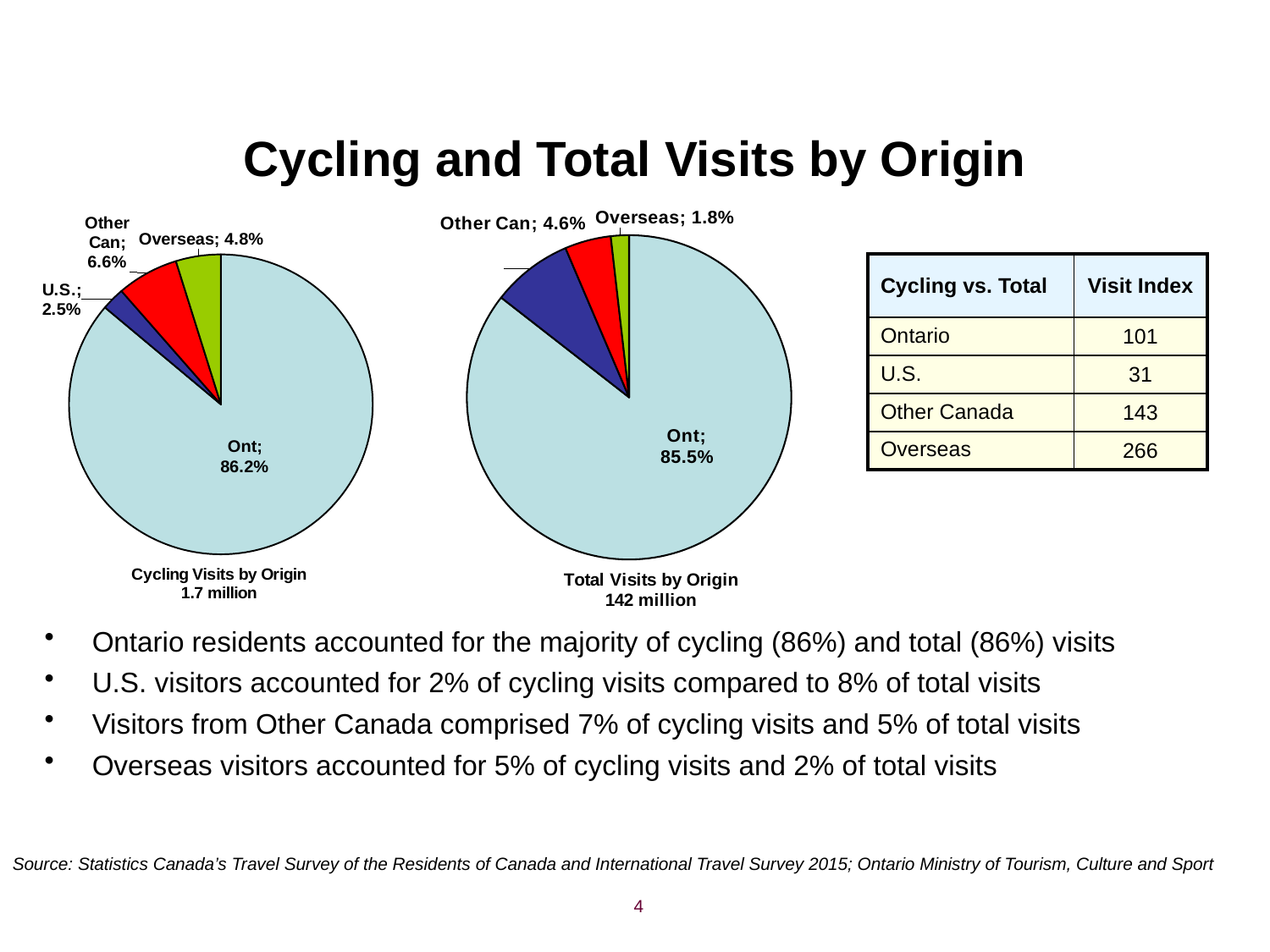
How many slices does the Cycling Visits by Origin pie chart have? 4 In the Cycling Visits by Origin pie chart, what share of visits is from Ontario? 86.2% In the Total Visits by Origin pie chart, what share of visits is from Ontario? 85.5% In the Cycling Visits by Origin pie chart, which is larger: the Other Can slice or the Overseas slice? Other Can In the Cycling Visits by Origin pie chart, which origin has the smallest slice? U.S. In the Cycling Visits by Origin pie chart, what share of visits is from the U.S.? 2.5% In the Cycling Visits by Origin pie chart, what share of visits is from Overseas? 4.8% In the Total Visits by Origin pie chart, which origin has the largest slice? Ont In the Total Visits by Origin pie chart, what share of visits is from Other Can? 4.6% In the Cycling Visits by Origin pie chart, what is the difference between the Other Can share and the Overseas share? 1.8% What total number of visits is stated beneath the Total Visits by Origin pie chart? 142 million What type of chart is used for Total Visits by Origin? Pie chart